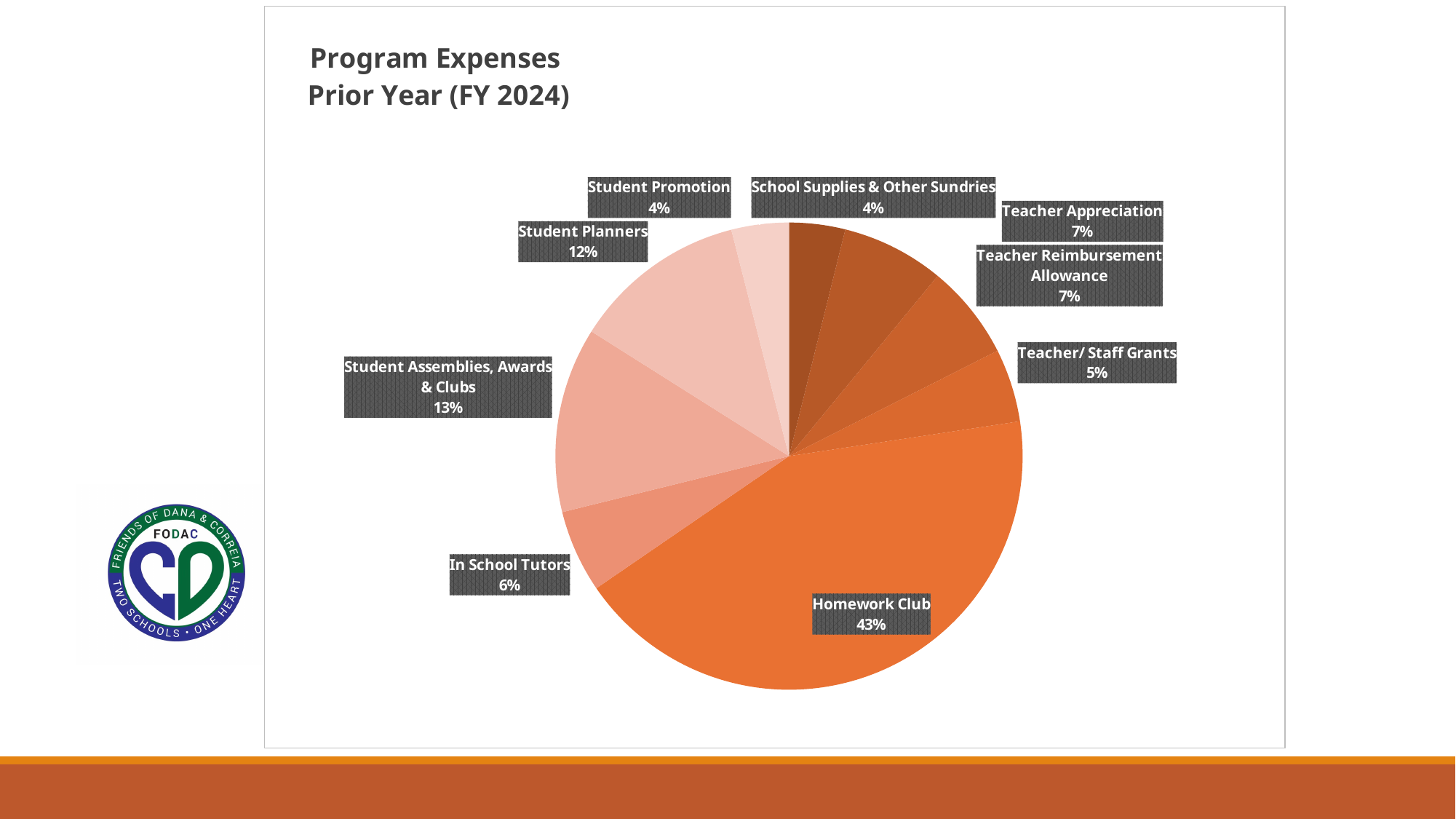
What percentage is shown for Teacher/ Staff Grants? 5% What is the difference in percentage points between Homework Club and Student Assemblies, Awards & Clubs? 30 How many categories are shown in the pie chart? 9 What is the difference in percentage points between Student Assemblies, Awards & Clubs and Student Planners? 1 Which is larger, Student Planners or Teacher Appreciation? Student Planners What share of program expenses does Homework Club represent? 43% What percentage is shown for Teacher Reimbursement Allowance? 7% What percentage is shown for Student Planners? 12% What percentage is shown for In School Tutors? 6% What type of chart is shown on the slide? pie chart Which category has the largest share of program expenses? Homework Club What is the title of the chart? Program Expenses Prior Year (FY 2024)